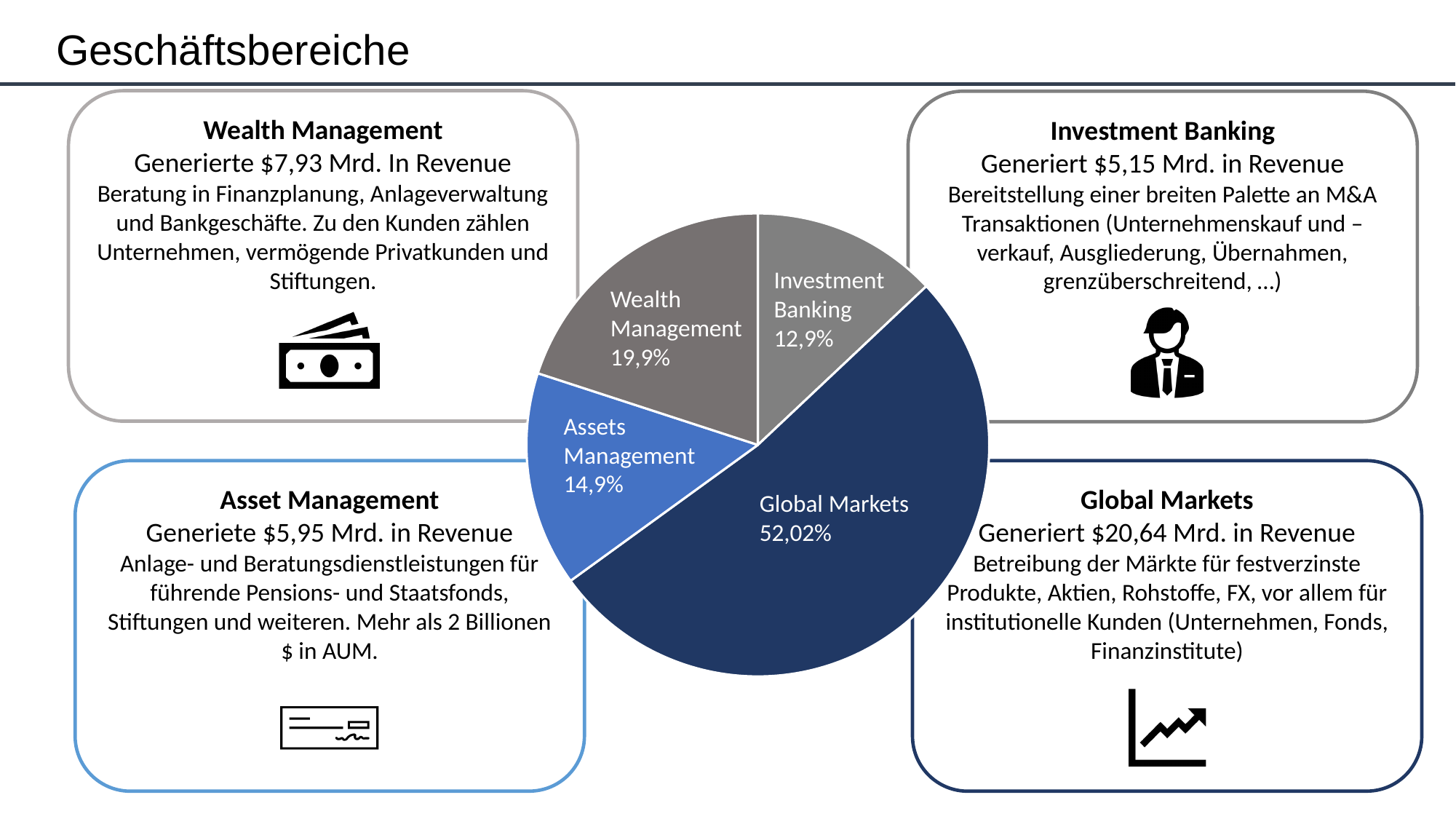
What colour is the Assets Management slice? blue What is the difference in percentage points between the Wealth Management slice and the Investment Banking slice? 7,0 percentage points Is the share for Global Markets greater or less than 50%? greater What share of the pie does Assets Management have? 14,9% What share of the pie does Wealth Management have? 19,9% Which slice of the pie is the smallest? Investment Banking What kind of chart is shown on the slide? pie chart How many slices does the pie chart have? 4 What share of the pie does Investment Banking have? 12,9% Which is larger, the Wealth Management slice or the Assets Management slice? Wealth Management Which slice of the pie is the largest? Global Markets